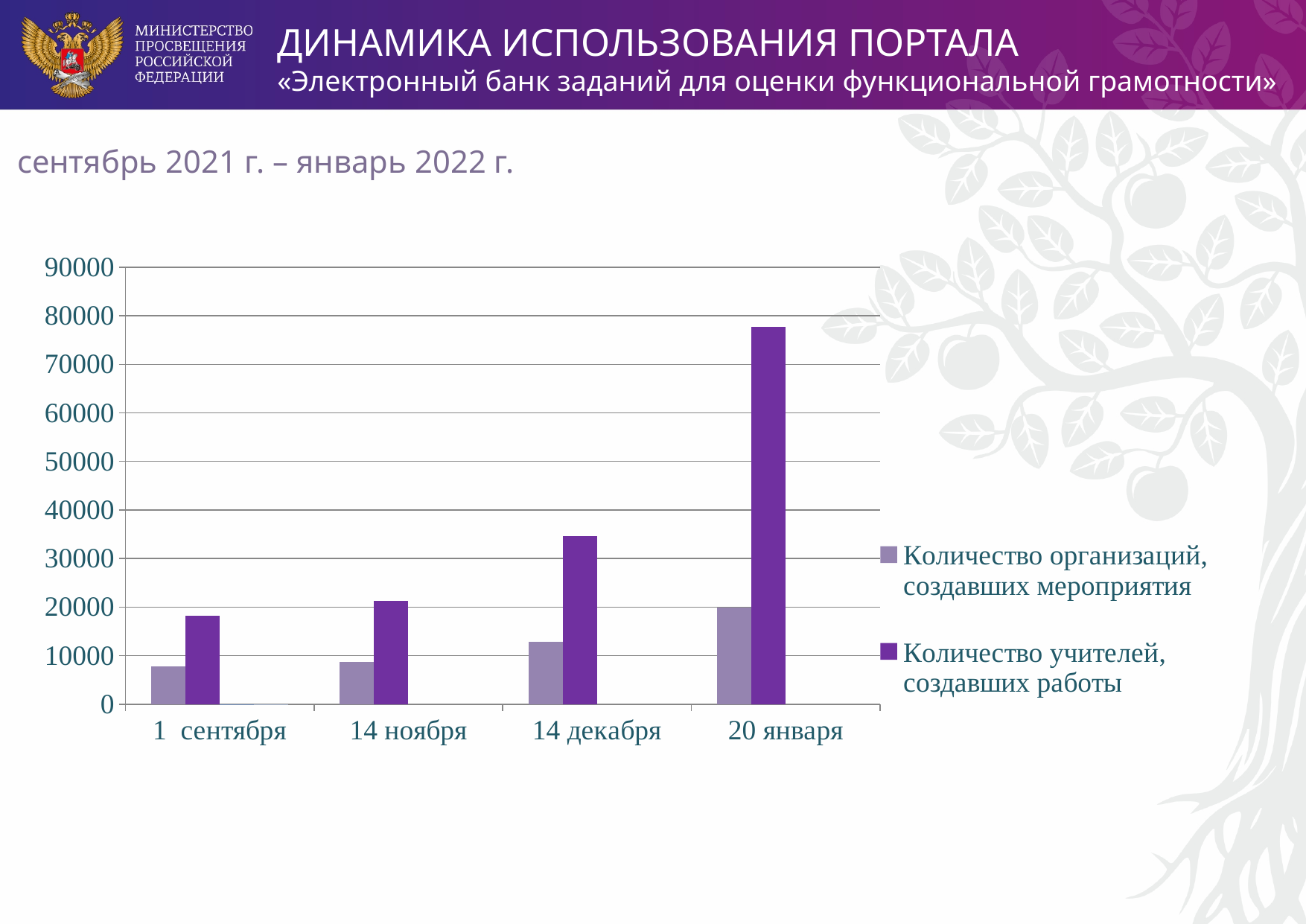
How many dates are shown along the x axis? 4 On 20 января, which is larger: «Количество учителей, создавших работы» or «Количество организаций, создавших мероприятия»? Количество учителей, создавших работы On which date is the value for «Количество организаций, создавших мероприятия» lowest? 1 сентября Which colour represents «Количество учителей, создавших работы» in the legend? dark purple Is the value for «Количество организаций, создавших мероприятия» on 1 сентября greater or less than 10000? less On which date is the value for «Количество учителей, создавших работы» highest? 20 января Do the values for «Количество учителей, создавших работы» rise or fall from 1 сентября to 20 января? rise Is the value for «Количество учителей, создавших работы» on 20 января greater or less than 70000? greater How many series does the legend list? 2 Is the value for «Количество учителей, создавших работы» on 14 ноября greater or less than 30000? less What kind of chart is shown on the slide? bar chart